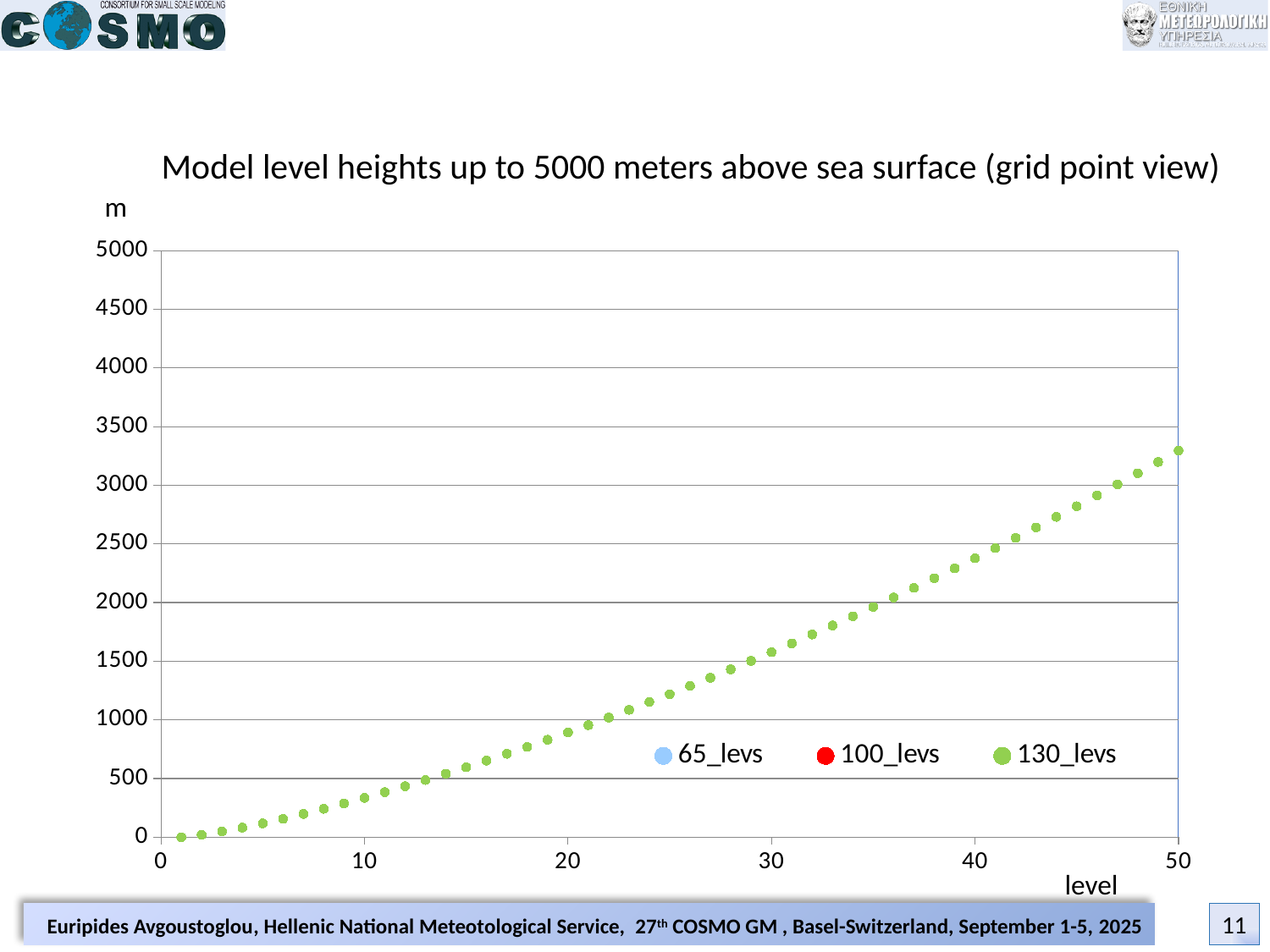
What kind of chart is shown on the slide? scatter chart Is the height at level 20 greater or less than 500? greater Which is larger, the height at level 30 or the height at level 20? level 30 Which level has the highest plotted height? 50 Is the height at level 50 greater or less than 3000? greater What is the title of the chart? Model level heights up to 5000 meters above sea surface (grid point view) How many series does the legend list? 3 Do the plotted heights rise or fall as the level number increases? rise Is the height at level 40 greater or less than 2000? greater Which series is plotted with green markers? 130_levs